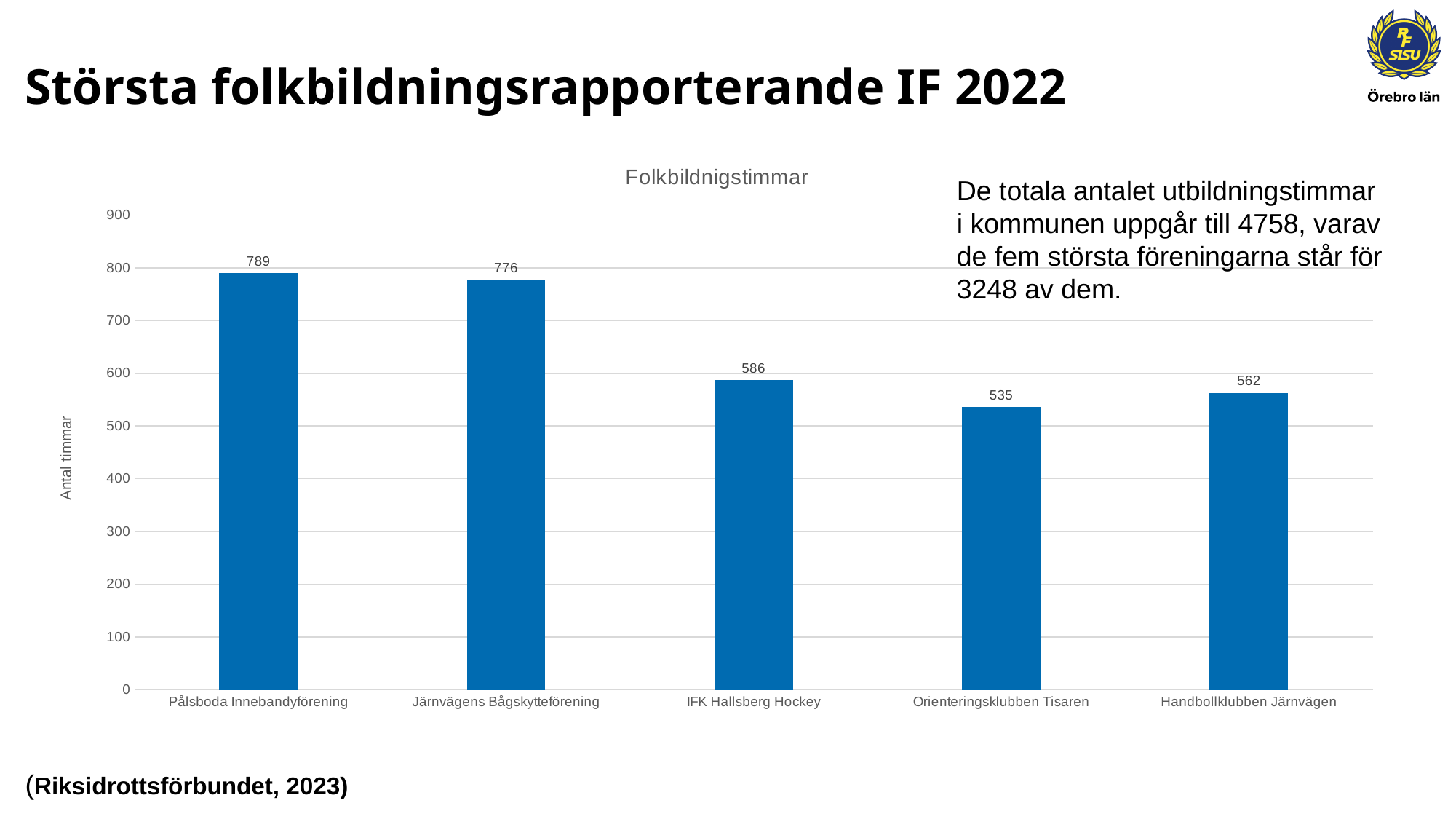
Which is larger, the value for IFK Hallsberg Hockey or the value for Handbollklubben Järnvägen? IFK Hallsberg Hockey What is the value for IFK Hallsberg Hockey? 586 Is the value for Järnvägens Bågskytteförening greater or less than 700? greater Which category has the lowest value? Orienteringsklubben Tisaren What is the value for Pålsboda Innebandyförening? 789 Which category has the highest value? Pålsboda Innebandyförening What is the value for Orienteringsklubben Tisaren? 535 How many categories are shown in the chart? 5 What is the value for Handbollklubben Järnvägen? 562 What is the title of the chart? Folkbildnigstimmar What kind of chart is shown on the slide? bar chart What is the difference between the values for Pålsboda Innebandyförening and Järnvägens Bågskytteförening? 13